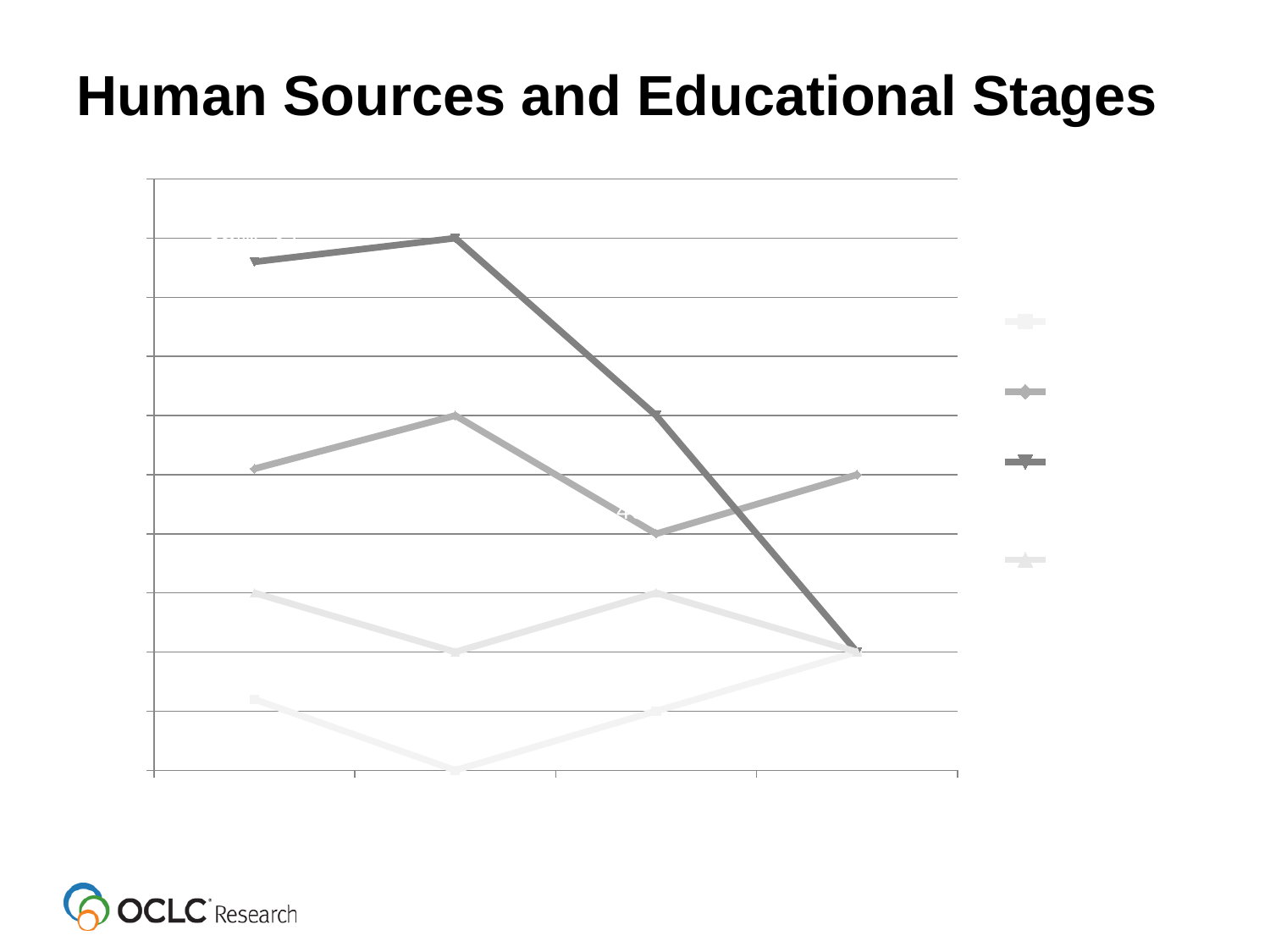
What is the title of the slide containing the chart? Human Sources and Educational Stages How many lines are plotted on the chart? 4 Does the darkest grey line end higher or lower than it starts? lower How many series does the legend list? 4 Which line is lowest at the first x-axis position? the lightest (near-white) line Does the lightest line rise or fall between its first and second points? fall Which line is highest at the first x-axis position? the darkest grey line What kind of chart is shown on the slide? line chart At the last x-axis position, which is higher: the darkest grey line or the medium grey line? the medium grey line From its second point to its last point, does the darkest grey line rise or fall? fall How many data points does each line have along the x axis? 4